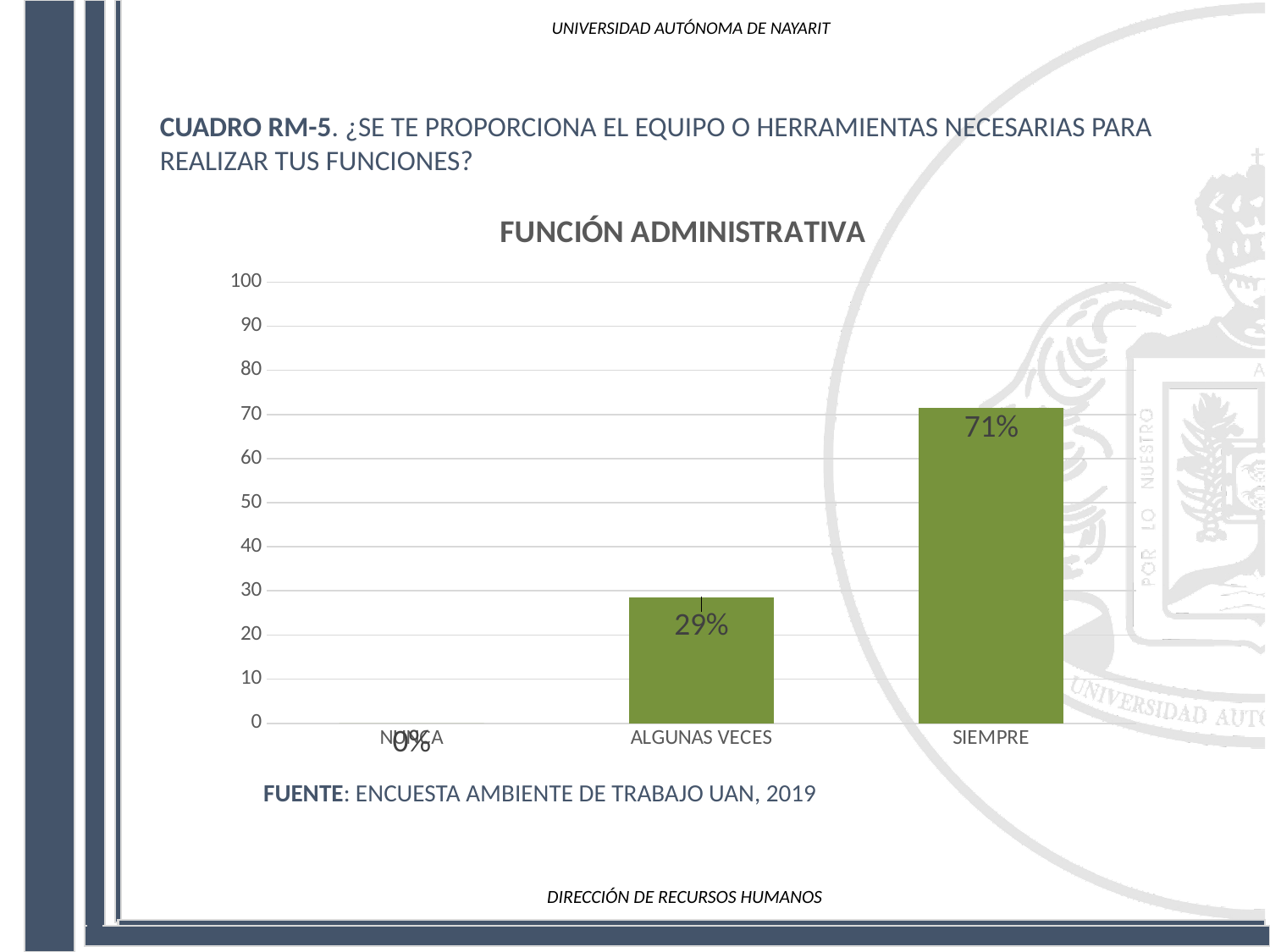
What is the value for ALGUNAS VECES? 29% What is the difference between the values for SIEMPRE and ALGUNAS VECES? 42% Is the value for SIEMPRE greater or less than 60? greater How many categories are shown on the x axis? 3 Do the values rise or fall from left to right along the x axis? rise What kind of chart is shown on the slide? bar chart What is the title of the chart? FUNCIÓN ADMINISTRATIVA Which is larger, the value for ALGUNAS VECES or the value for SIEMPRE? SIEMPRE Which category has the highest value? SIEMPRE Which category has the lowest value? NUNCA What is the value for NUNCA? 0% What is the value for SIEMPRE? 71%